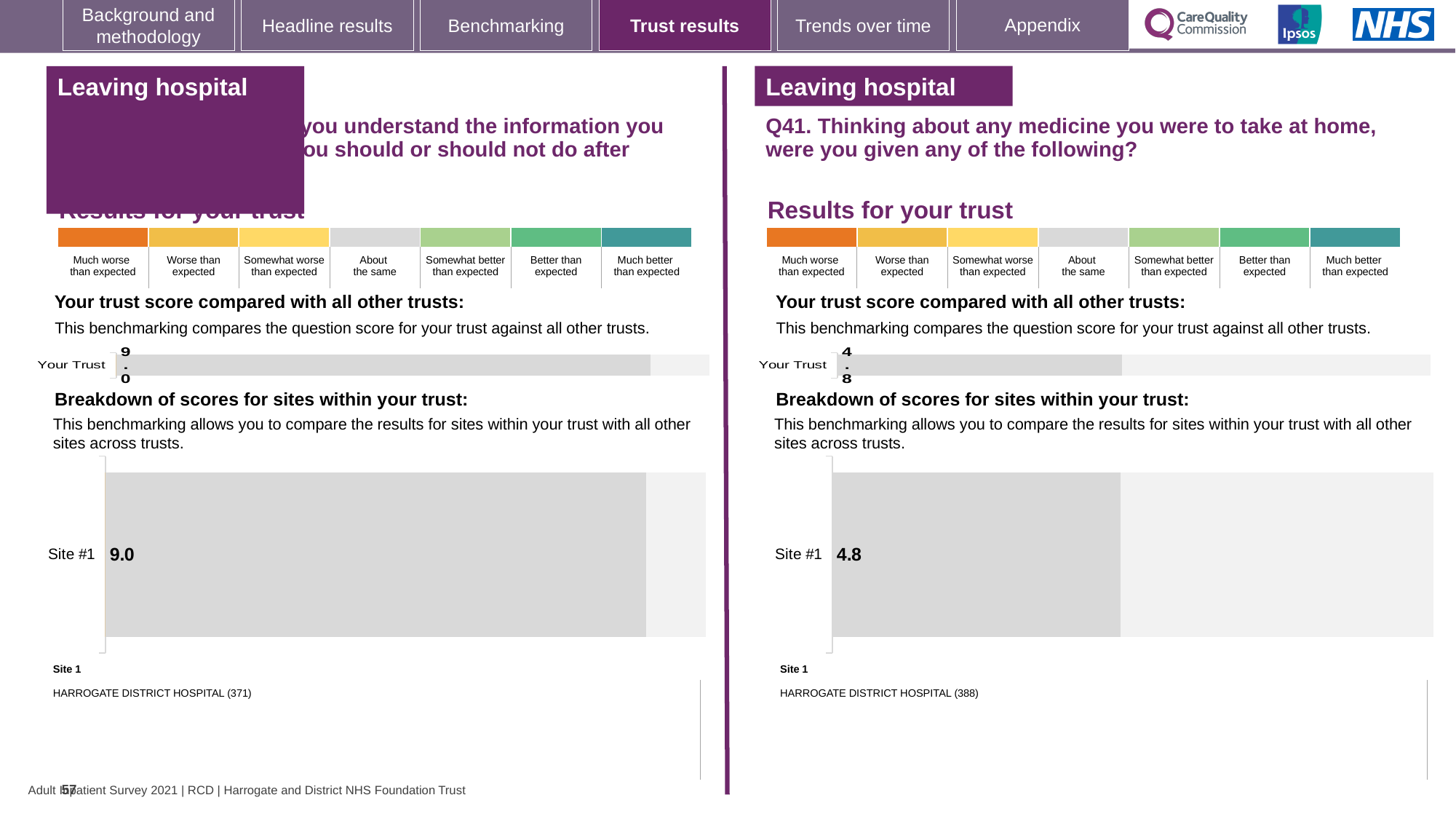
Which is larger: the Site #1 score on the left panel or the Site #1 score on the right panel (Q41)? Left panel (9.0) On the left panel's 'Your trust score compared with all other trusts' chart, what is the value shown for Your Trust? 9.0 On the right panel (Q41) 'Breakdown of scores for sites within your trust' chart, what is the score for Site #1? 4.8 What kind of chart is used for the Site #1 breakdown on the left panel? Bar chart What kind of chart is used for the Your Trust score on the right panel (Q41)? Bar chart Which site name is listed under 'Site 1' on the left panel? HARROGATE DISTRICT HOSPITAL (371) How many sites are shown in the left panel's 'Breakdown of scores for sites within your trust' chart? 1 Which site name is listed under 'Site 1' on the right panel (Q41)? HARROGATE DISTRICT HOSPITAL (388) What is the difference between the Site #1 score on the left panel and the Site #1 score on the right panel (Q41)? 4.2 How many sites are shown in the right panel (Q41) 'Breakdown of scores for sites within your trust' chart? 1 On the right panel (Q41) 'Your trust score compared with all other trusts' chart, what is the value shown for Your Trust? 4.8 On the left panel's 'Breakdown of scores for sites within your trust' chart, what is the score for Site #1? 9.0